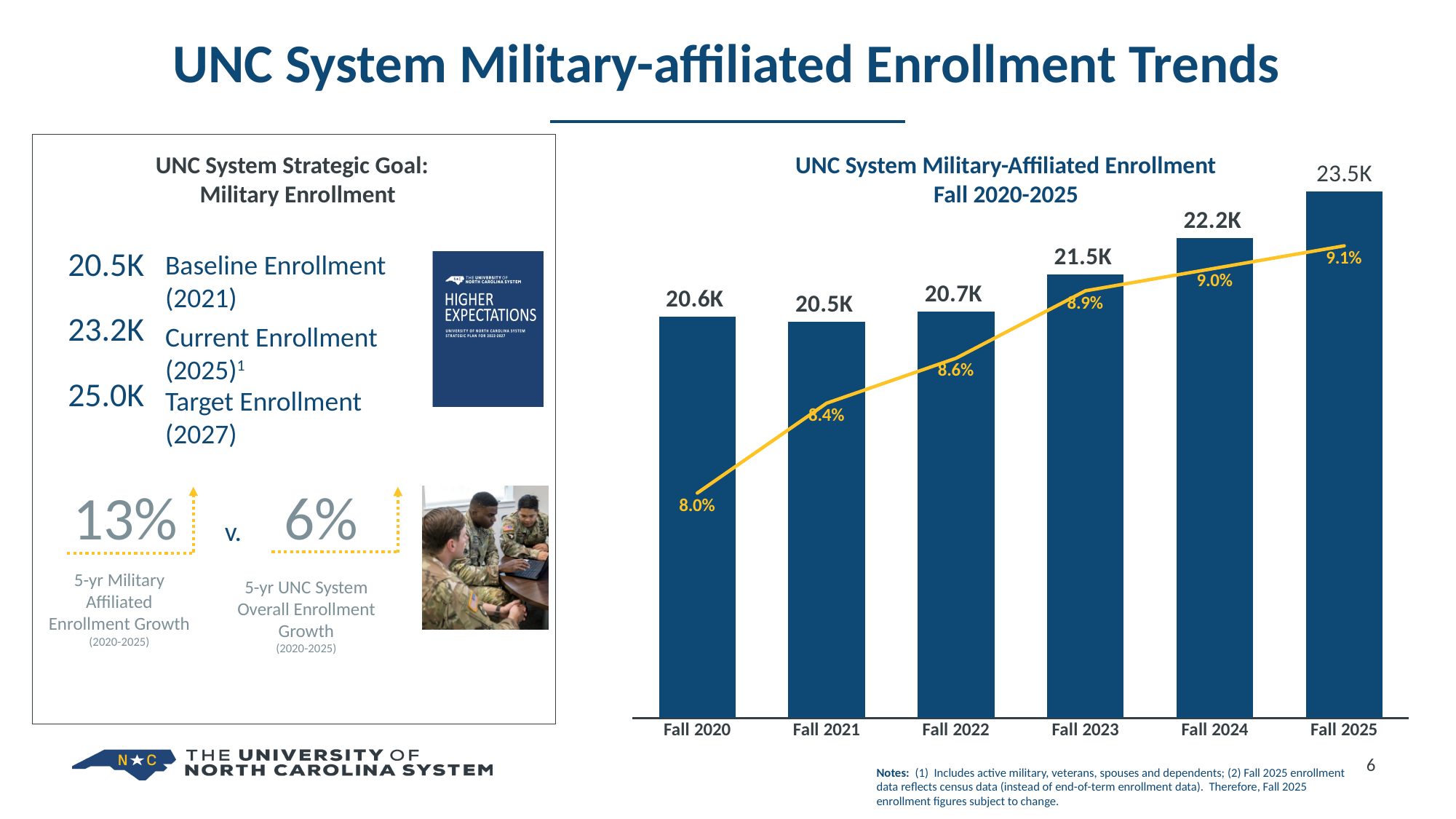
What is the enrollment value shown for Fall 2023 in the UNC System Military-Affiliated Enrollment chart? 21.5K How many fall terms are shown on the x axis of the chart? 6 Which fall term has the lowest enrollment bar in the chart? Fall 2021 What percentage is shown on the line for Fall 2022 in the chart? 8.6% What is the difference in enrollment between Fall 2025 and Fall 2024 in the chart? 1.3K What percentage is shown on the line for Fall 2025 in the chart? 9.1% Do the line percentages rise or fall from Fall 2020 to Fall 2025 in the chart? Rise What is the enrollment value shown for Fall 2020 in the chart? 20.6K What kind of chart is used to show the enrollment values in the UNC System Military-Affiliated Enrollment chart? Bar chart with a line overlay Which is larger in the chart, the enrollment for Fall 2022 or Fall 2023? Fall 2023 What is the difference between the line percentages for Fall 2025 and Fall 2020? 1.1% Which fall term has the highest enrollment bar in the chart? Fall 2025